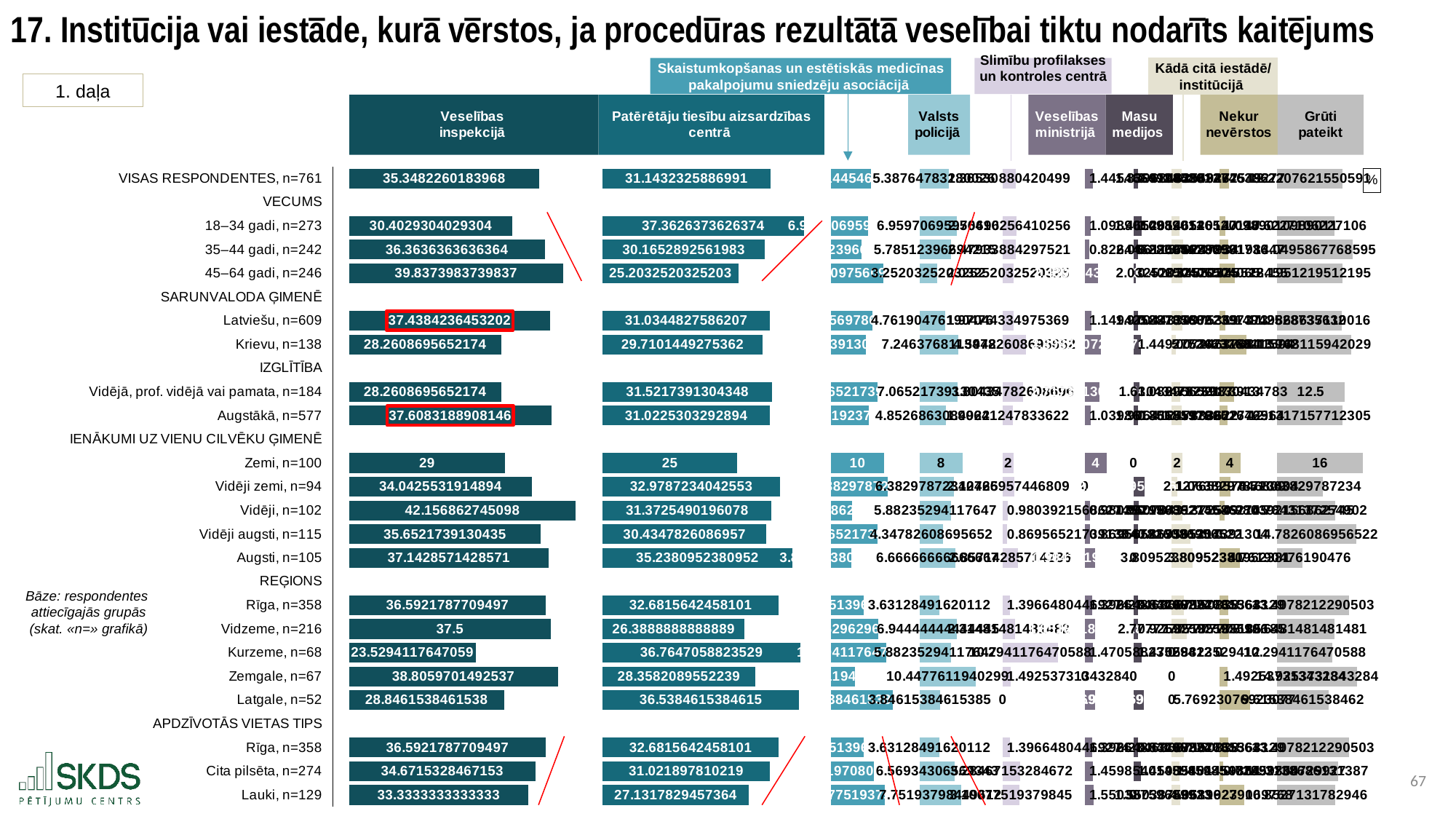
Which row has the lowest value for 'Veselības inspekcijā'? Kurzeme, n=68 In the row 'Zemi, n=100', what is the difference between the values for 'Veselības inspekcijā' and 'Patērētāju tiesību aizsardzības centrā'? 4 How many series (institutions) does the chart legend list? 10 What is the value for 'Veselības inspekcijā' in the row 'Kurzeme, n=68'? 23.5294117647059 What is the value for 'Veselības inspekcijā' in the row 'VISAS RESPONDENTES, n=761'? 35.3482260183968 What is the value for 'Grūti pateikt' in the row 'Zemi, n=100'? 16 In the row 'Zemi, n=100', what is the value for 'Valsts policijā'? 8 What is the value for 'Veselības inspekcijā' in the row 'Vidzeme, n=216'? 37.5 In the row 'Kurzeme, n=68', which is larger: the value for 'Veselības inspekcijā' or for 'Patērētāju tiesību aizsardzības centrā'? Patērētāju tiesību aizsardzības centrā What is the value for 'Patērētāju tiesību aizsardzības centrā' in the row '18–34 gadi, n=273'? 37.3626373626374 Which row has the highest value for 'Veselības inspekcijā'? Vidēji, n=102 What kind of chart is shown on the slide? bar chart